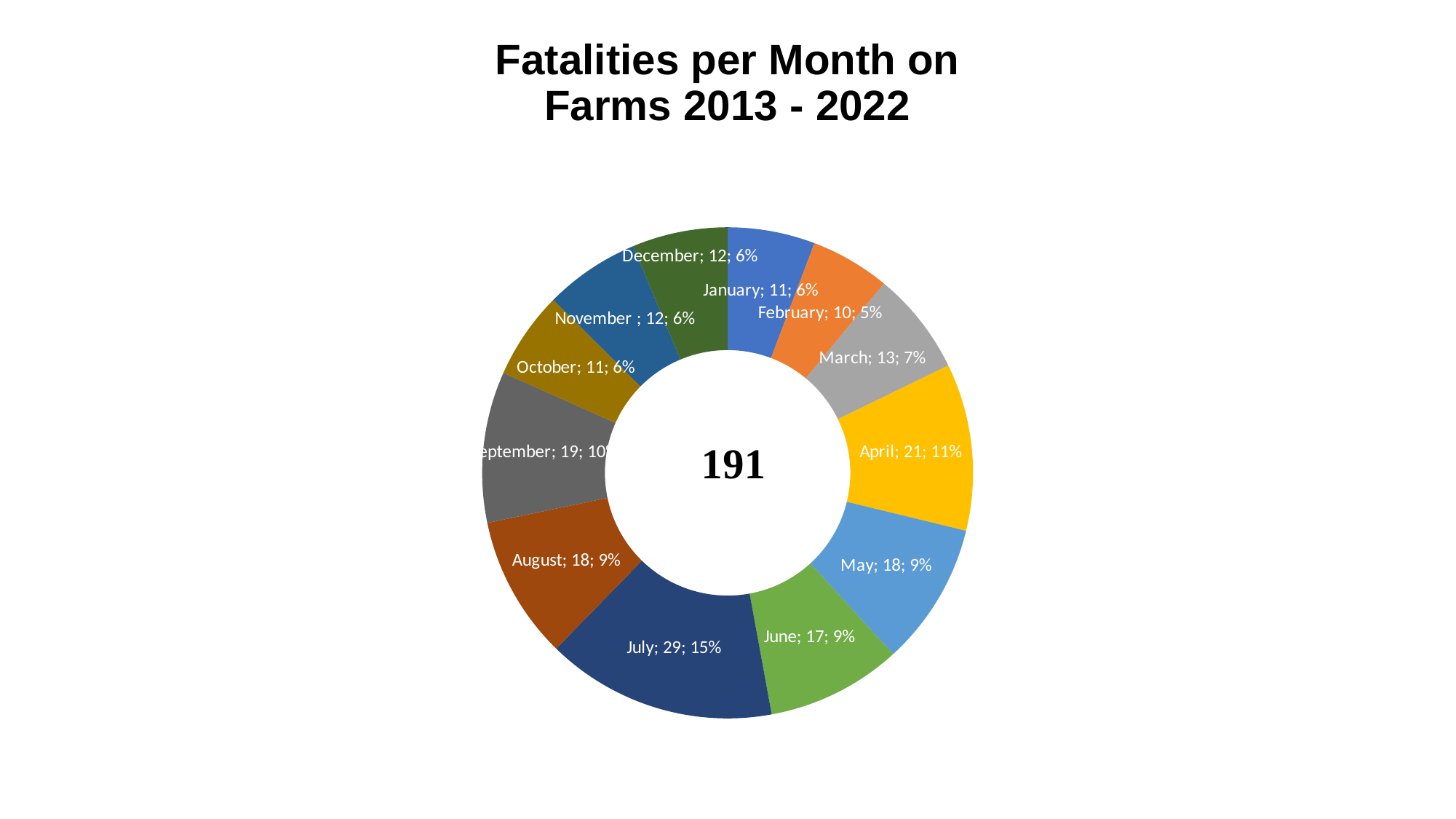
How many fatalities are shown for March? 13 What kind of chart is shown on the slide? Doughnut (pie) chart Which has more fatalities, April or September? April What percentage share does April have? 11% How many fatalities are shown for July? 29 Which month has the lowest number of fatalities? February What percentage share does July have? 15% Which month has the highest number of fatalities? July What total number is printed in the centre of the doughnut? 191 What is the difference in fatalities between July and February? 19 What is the title of the chart? Fatalities per Month on Farms 2013 - 2022 How many months (categories) are shown in the chart? 12